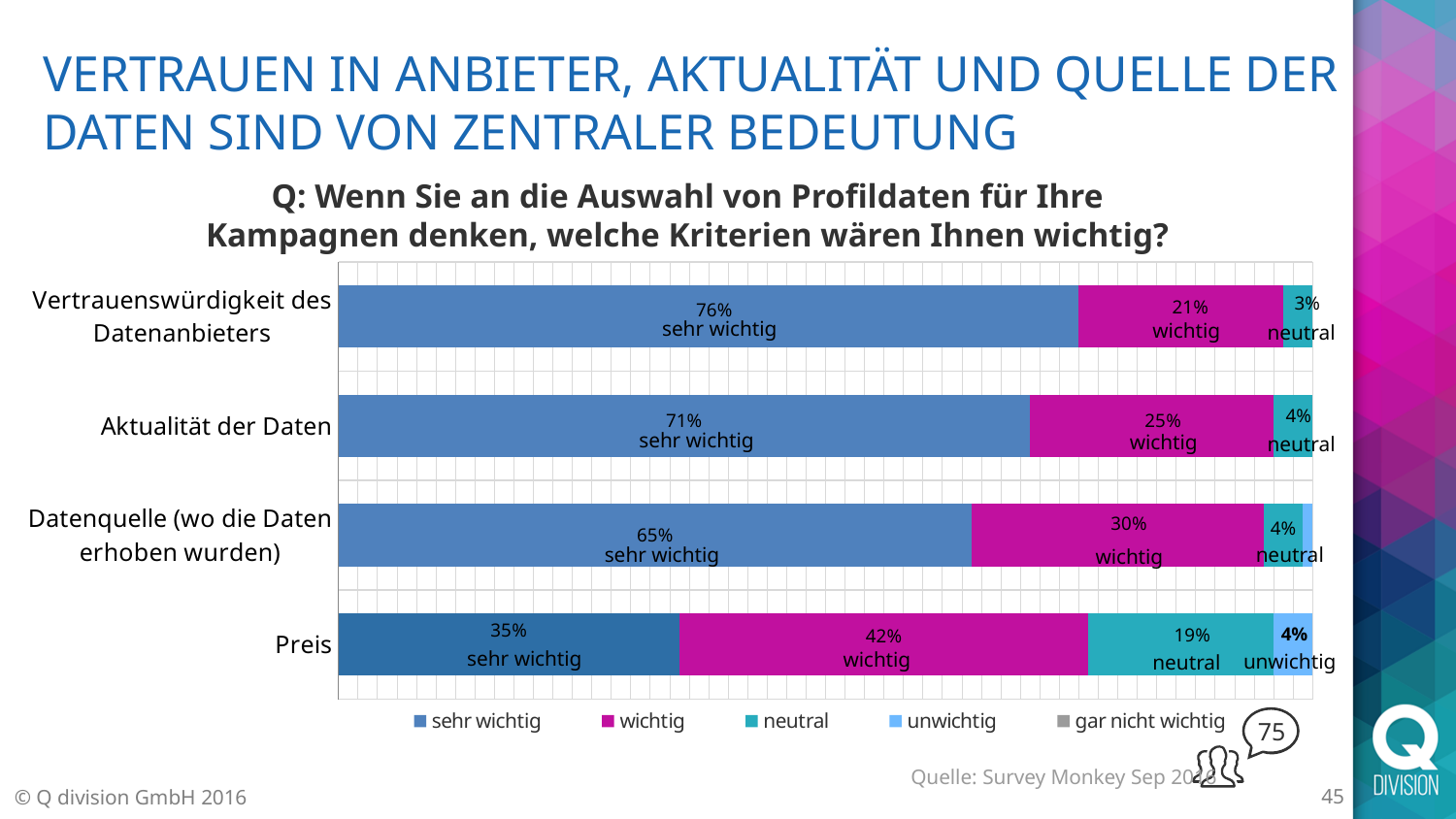
Which category has the highest 'sehr wichtig' value? Vertrauenswürdigkeit des Datenanbieters What is the 'wichtig' value for 'Aktualität der Daten'? 25% What is the 'sehr wichtig' value for 'Vertrauenswürdigkeit des Datenanbieters'? 76% Which is larger: the 'wichtig' value for 'Preis' or the 'wichtig' value for 'Datenquelle (wo die Daten erhoben wurden)'? Preis What is the 'unwichtig' value for 'Preis'? 4% What is the difference between the 'sehr wichtig' values for 'Aktualität der Daten' and 'Datenquelle (wo die Daten erhoben wurden)'? 6% How many series does the legend list? 5 What is the 'neutral' value for 'Preis'? 19% How many categories are plotted on the chart? 4 Which category has the lowest 'sehr wichtig' value? Preis What kind of chart is shown on the slide? stacked bar chart Which legend entry is shown in magenta? wichtig